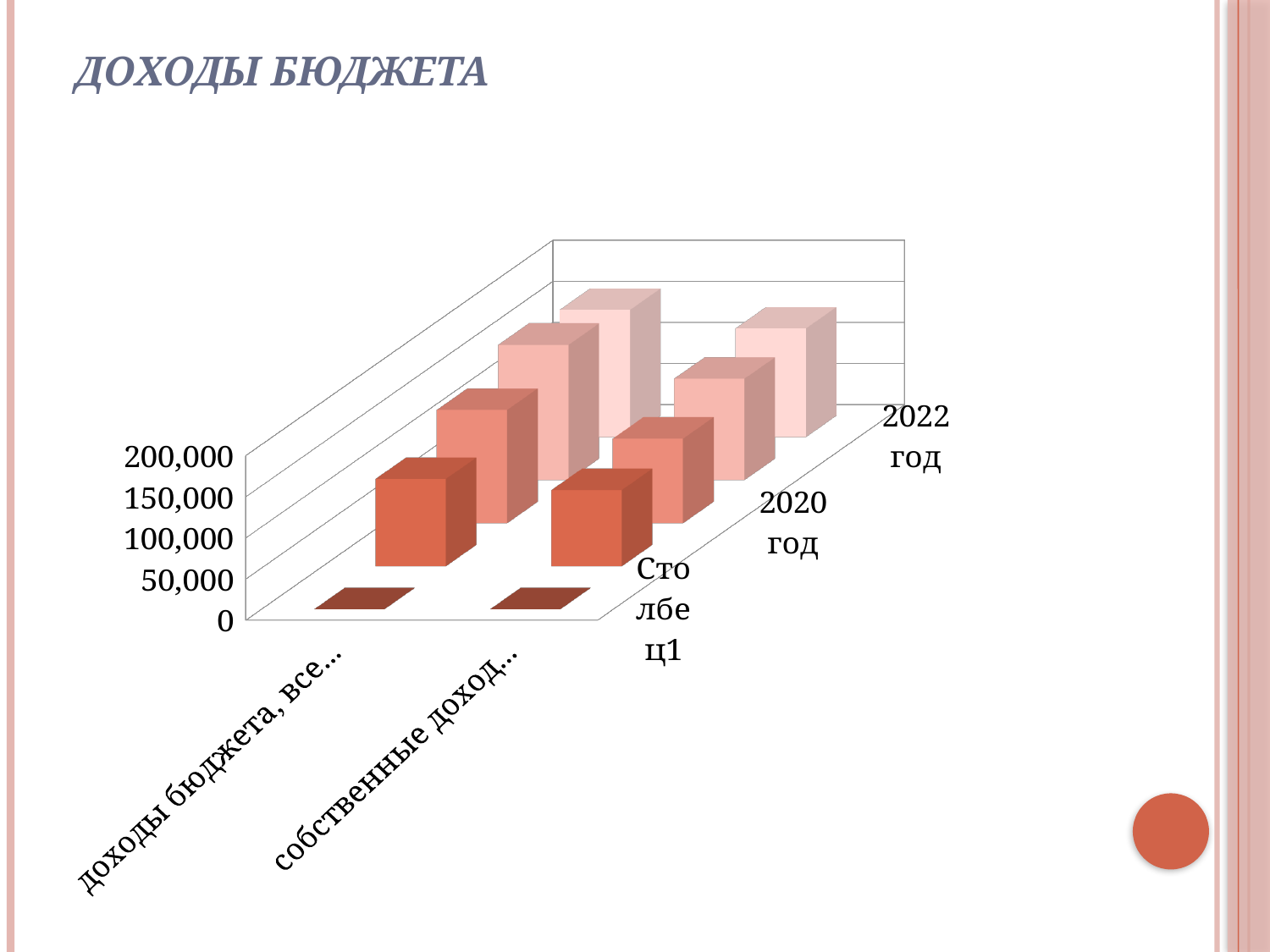
What is the title of the slide containing the chart? ДОХОДЫ БЮДЖЕТА Is the value for Столбец1 in the category 'собственные доход...' greater or less than 50,000? less What kind of chart is shown on the slide? bar chart How many categories are shown along the horizontal axis of the chart? 2 Is the value for Столбец1 in the category 'доходы бюджета, все...' greater or less than 50,000? less Which year labels are readable on the depth axis of the chart? 2020 год, 2022 год